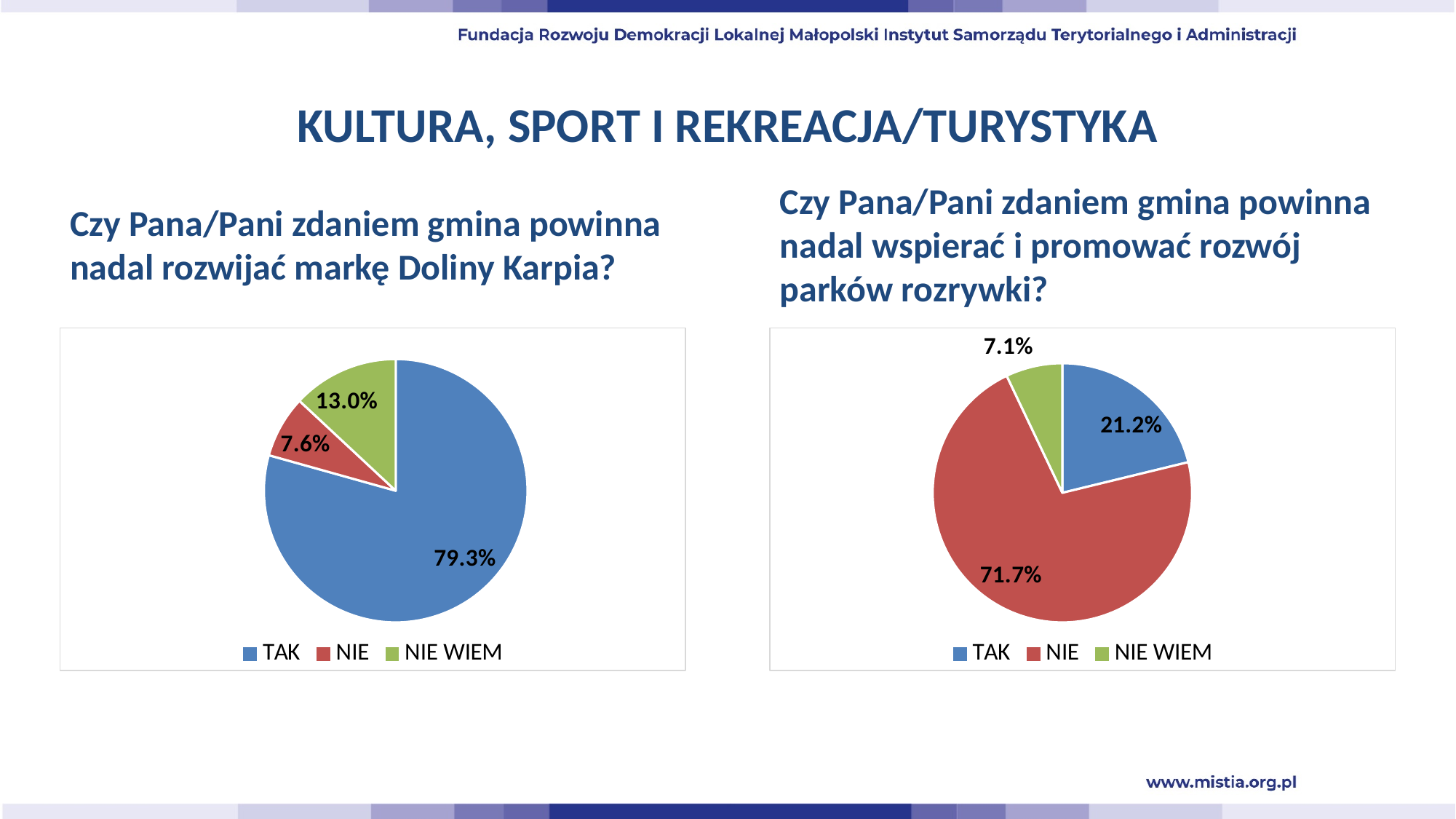
How many slices does the right pie chart (parków rozrywki) have? 3 In the right pie chart (parków rozrywki), what share of respondents answered NIE WIEM? 7.1% In the right pie chart (parków rozrywki), what share of respondents answered NIE? 71.7% In the right pie chart (parków rozrywki), what share of respondents answered TAK? 21.2% In the left pie chart (Doliny Karpia), which answer has the largest share? TAK In the right pie chart (parków rozrywki), which answer has the smallest share? NIE WIEM Which is larger: the TAK share in the left pie chart or the TAK share in the right pie chart? The left pie chart (79.3%) In the left pie chart (Doliny Karpia), what is the difference between the TAK and NIE WIEM shares? 66.3% In the left pie chart (Doliny Karpia), what share of respondents answered NIE? 7.6% In the left pie chart (Doliny Karpia), what share of respondents answered TAK? 79.3% What type of chart is used on this slide? Pie chart In the left pie chart (Doliny Karpia), what share of respondents answered NIE WIEM? 13.0%